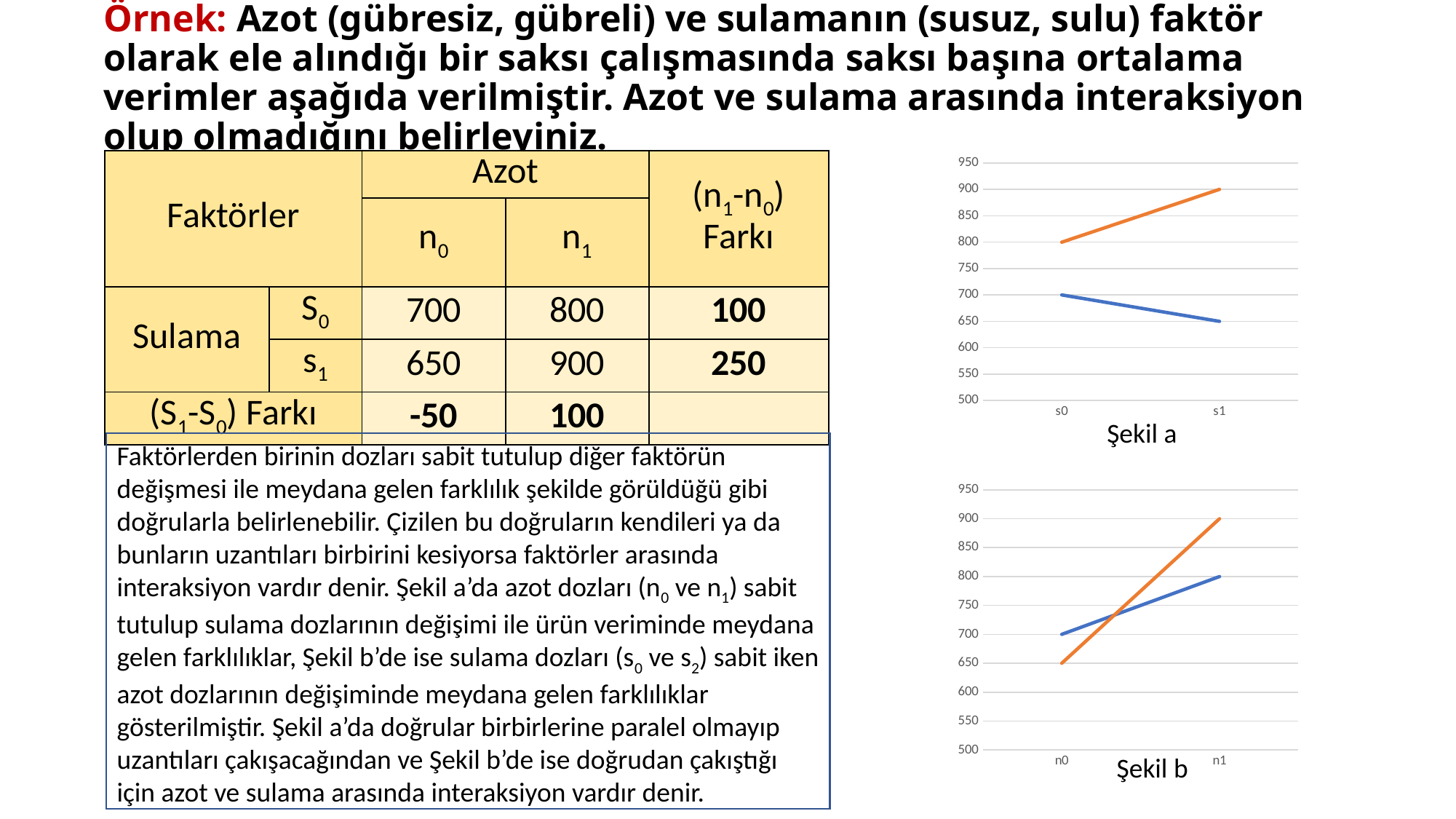
In the chart titled Şekil b, what value does the orange line have at n0? 650 In the chart titled Şekil b, what value does the blue line reach at n1? 800 In the chart titled Şekil b, is the value of the blue line at n0 greater or less than 750? less In the chart titled Şekil a, does the blue line rise or fall from s0 to s1? fall In the chart titled Şekil a, what value does the blue line have at s0? 700 In the chart titled Şekil a, how many categories are shown on the x axis? 2 In the chart titled Şekil b, what is the difference between the orange line's value at n1 and its value at n0? 250 In the chart titled Şekil a, what value does the orange line reach at s1? 900 In the chart titled Şekil a, does the orange line rise or fall from s0 to s1? rise In the chart titled Şekil a, what type of chart is shown? line chart In the chart titled Şekil a, which line is higher at s1, the orange line or the blue line? orange line In the chart titled Şekil b, how many lines are plotted? 2